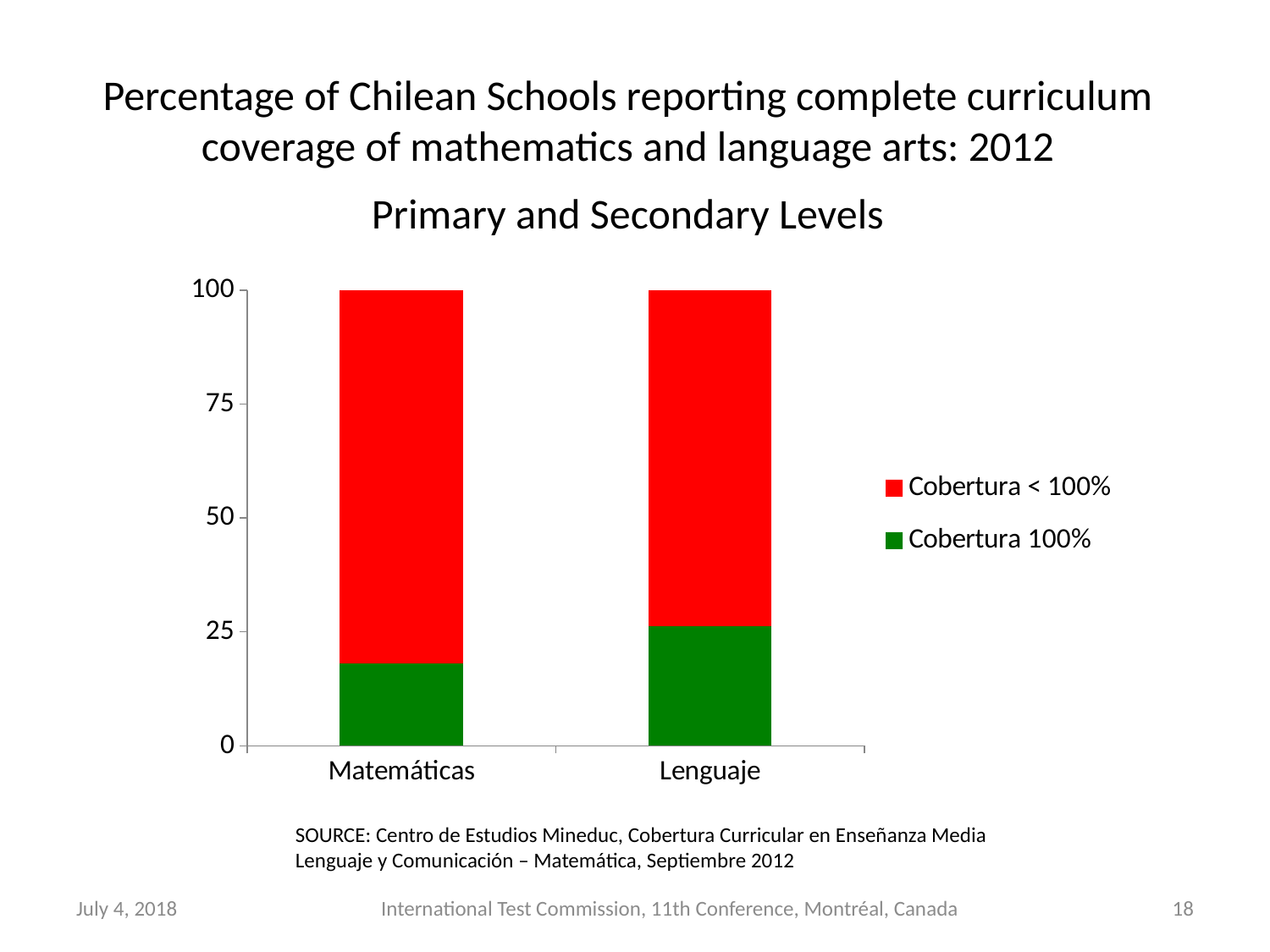
Which colour represents the 'Cobertura < 100%' series in the chart? Red Which category has the higher 'Cobertura 100%' value, Matemáticas or Lenguaje? Lenguaje How many series does the chart's legend list? 2 Is the 'Cobertura < 100%' value for Matemáticas greater or less than 75? greater Is the 'Cobertura 100%' value for Matemáticas greater or less than 25? less Which colour represents the 'Cobertura 100%' series in the chart? Green How many categories are shown on the x axis of the chart? 2 What kind of chart is shown on the slide? Stacked bar chart Which category has the lowest 'Cobertura 100%' value? Matemáticas Which category has the larger 'Cobertura < 100%' segment, Matemáticas or Lenguaje? Matemáticas What is the total height of the stacked bar for Lenguaje? 100